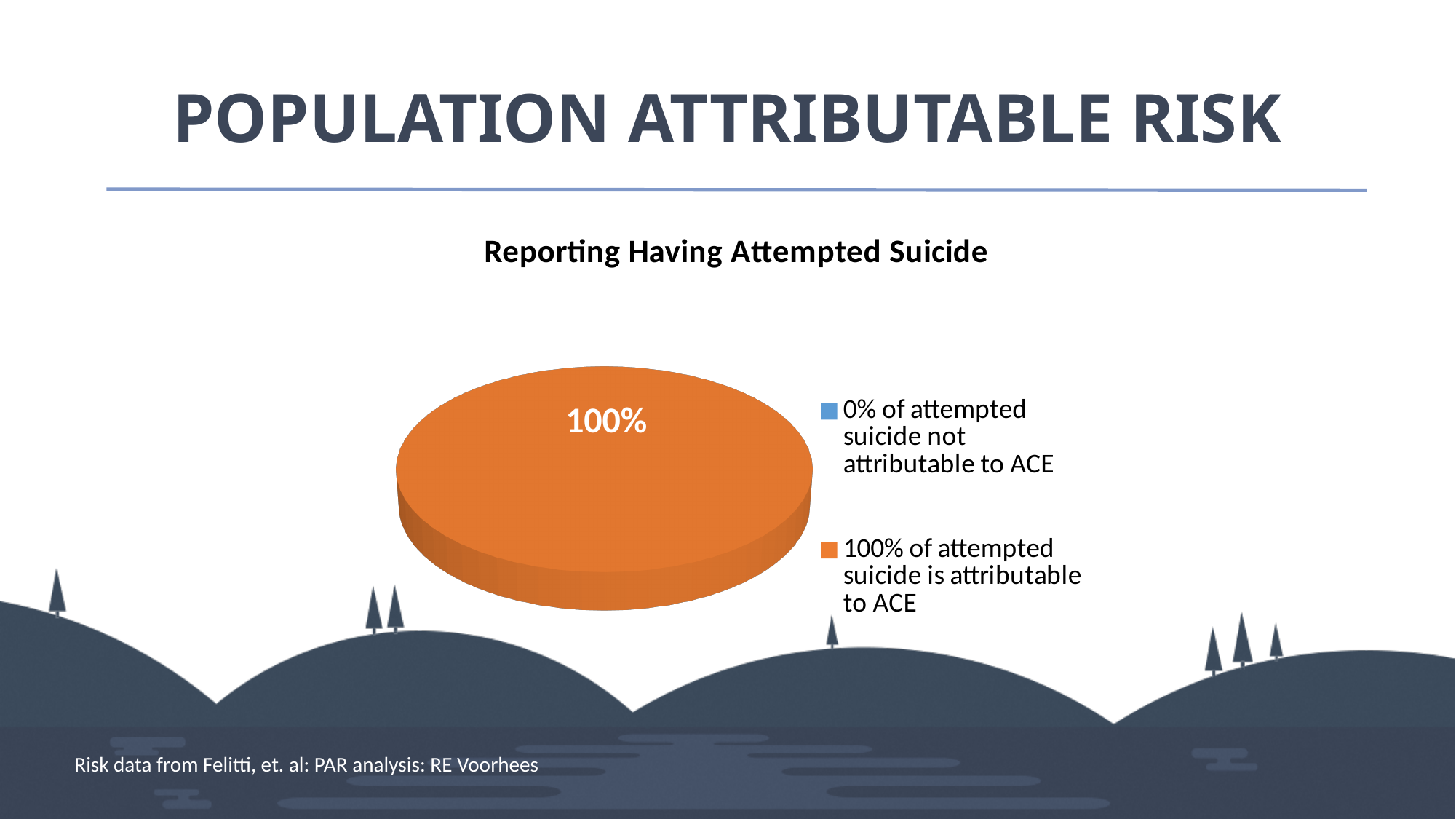
Which is larger: the share of attempted suicide attributable to ACE or the share not attributable to ACE? attributable to ACE What colour is the slice representing attempted suicide attributable to ACE? orange Which legend entry corresponds to the largest slice of the pie? 100% of attempted suicide is attributable to ACE How many entries does the chart's legend list? 2 What is the title of the chart? Reporting Having Attempted Suicide Which legend entry corresponds to the smallest share of the pie? 0% of attempted suicide not attributable to ACE What percentage is printed on the orange slice of the pie? 100% What kind of chart is shown on the slide? pie chart What share of the pie is attributed to attempted suicide attributable to ACE? 100% What is the difference between the share attributable to ACE and the share not attributable to ACE? 100% What share of the pie is attributed to attempted suicide not attributable to ACE? 0%